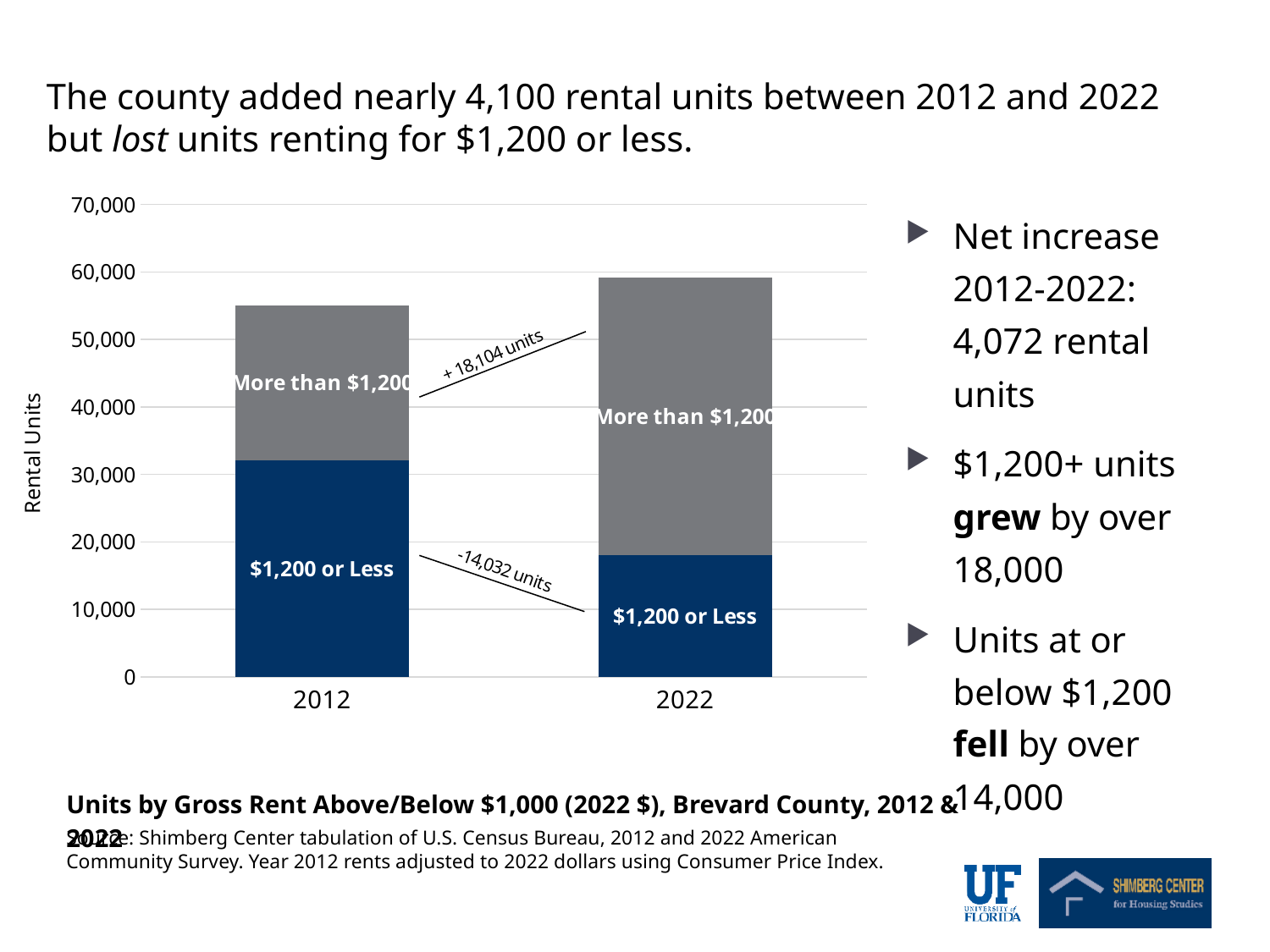
How many rent segments (series) are stacked in each bar? 2 How many years (categories) are shown on the x axis of the chart? 2 Which year has more 'More than $1,200' rental units, 2012 or 2022? 2022 Does the total number of rental units rise or fall from 2012 to 2022? Rise According to the annotation on the chart, by how many units did the 'More than $1,200' segment change between 2012 and 2022? + 18,104 units Is the number of '$1,200 or Less' units in 2012 greater or less than 30,000? greater Is the total height of the 2022 bar greater or less than 50,000 rental units? greater What kind of chart is shown on the slide? Stacked bar chart Is the number of '$1,200 or Less' units in 2022 greater or less than 20,000? less According to the annotation on the chart, by how many units did the '$1,200 or Less' segment change between 2012 and 2022? -14,032 units Which year has more '$1,200 or Less' rental units, 2012 or 2022? 2012 What is the label on the vertical axis of the chart? Rental Units